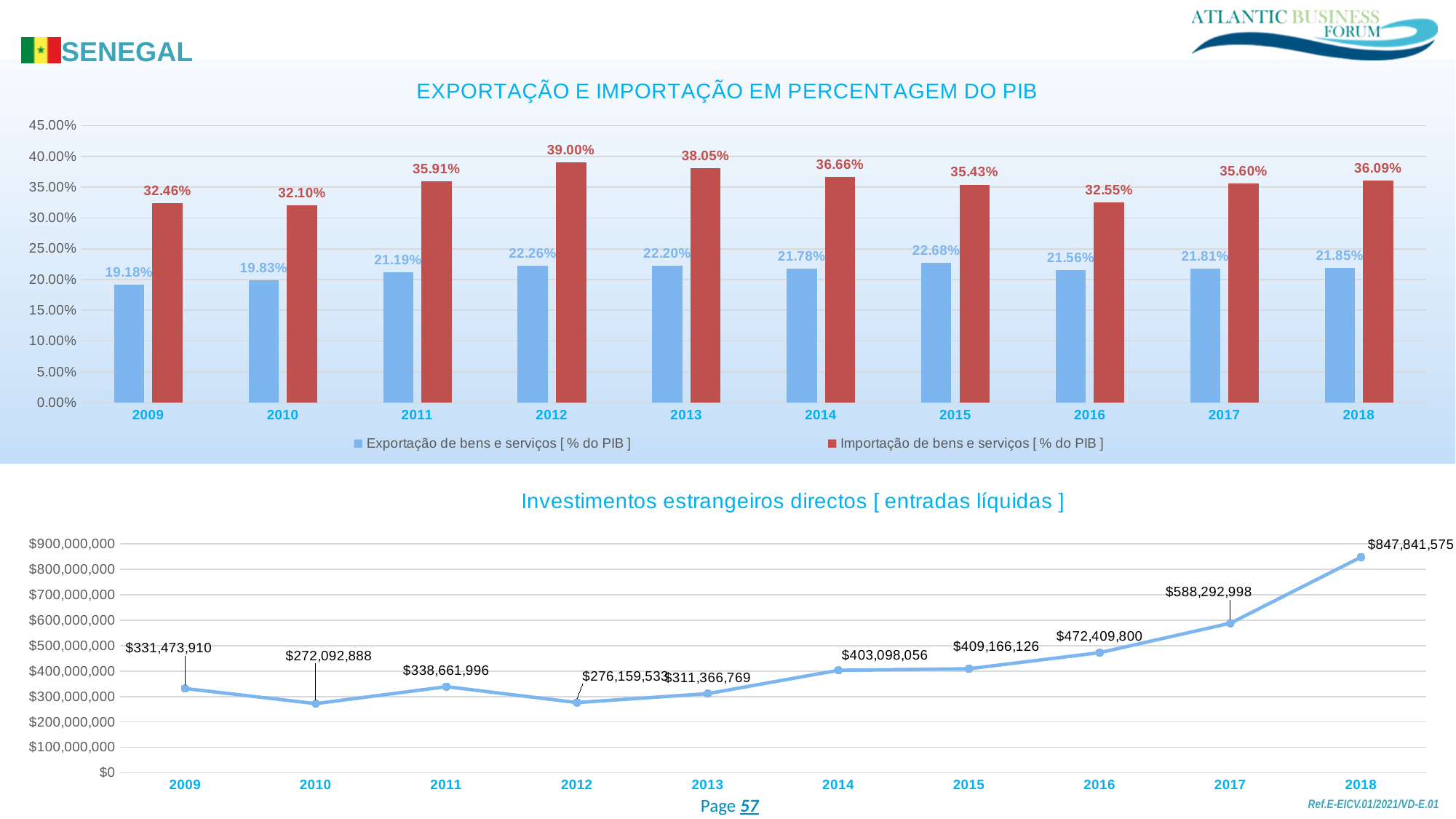
In the chart 'EXPORTAÇÃO E IMPORTAÇÃO EM PERCENTAGEM DO PIB', how many series does the legend list? 2 In the chart 'EXPORTAÇÃO E IMPORTAÇÃO EM PERCENTAGEM DO PIB', what is the difference between Importação and Exportação in 2012? 16.74% In the chart 'EXPORTAÇÃO E IMPORTAÇÃO EM PERCENTAGEM DO PIB', what is the value of Exportação de bens e serviços for 2015? 22.68% In the chart 'EXPORTAÇÃO E IMPORTAÇÃO EM PERCENTAGEM DO PIB', which year has the lowest Importação value? 2010 In the chart 'Investimentos estrangeiros directos [ entradas líquidas ]', what is the difference between the 2018 and 2017 values? $259,548,577 What kind of chart is 'EXPORTAÇÃO E IMPORTAÇÃO EM PERCENTAGEM DO PIB'? Bar chart In the chart 'Investimentos estrangeiros directos [ entradas líquidas ]', which year has the lowest value? 2010 In the chart 'Investimentos estrangeiros directos [ entradas líquidas ]', how many years are plotted? 10 In the chart 'Investimentos estrangeiros directos [ entradas líquidas ]', which year has the highest value? 2018 In the chart 'EXPORTAÇÃO E IMPORTAÇÃO EM PERCENTAGEM DO PIB', which year has the lowest Exportação value? 2009 In the chart 'EXPORTAÇÃO E IMPORTAÇÃO EM PERCENTAGEM DO PIB', what is the value of Importação de bens e serviços for 2012? 39.00% In the chart 'Investimentos estrangeiros directos [ entradas líquidas ]', what is the value for 2014? $403,098,056